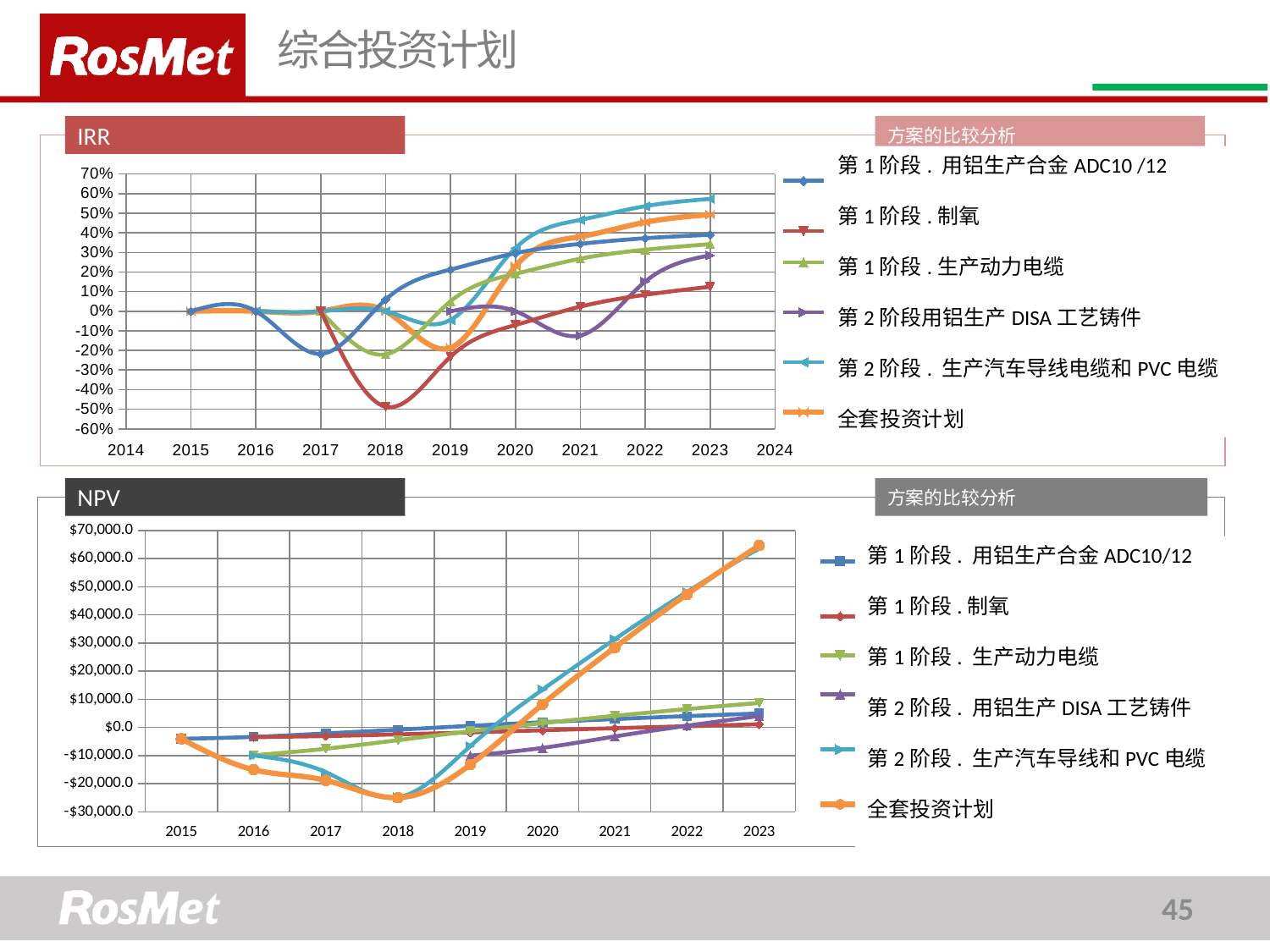
In the IRR chart, which series has the highest value in 2023? 第 2 阶段 . 生产汽车导线电缆和 PVC 电缆 In the IRR chart, is the value for 第 2 阶段 . 生产汽车导线电缆和 PVC 电缆 in 2023 greater or less than 50%? greater In the NPV chart, how many years are plotted on the x axis? 9 How many series does the legend of the IRR chart list? 6 In the IRR chart, which series has the lowest value in 2018? 第 1 阶段 . 制氧 In the IRR chart, is the value for 第 1 阶段 . 制氧 in 2018 greater or less than -40%? less What is the title of the bottom chart on the slide? NPV In the IRR chart, does the 全套投资计划 series rise or fall from 2019 to 2023? Rises In the NPV chart, is the value for 全套投资计划 in 2018 greater or less than -$20,000.0? less In the NPV chart, which is larger in 2023: 全套投资计划 or 第 1 阶段 . 制氧? 全套投资计划 What type of chart is the IRR chart at the top of the slide? Line chart